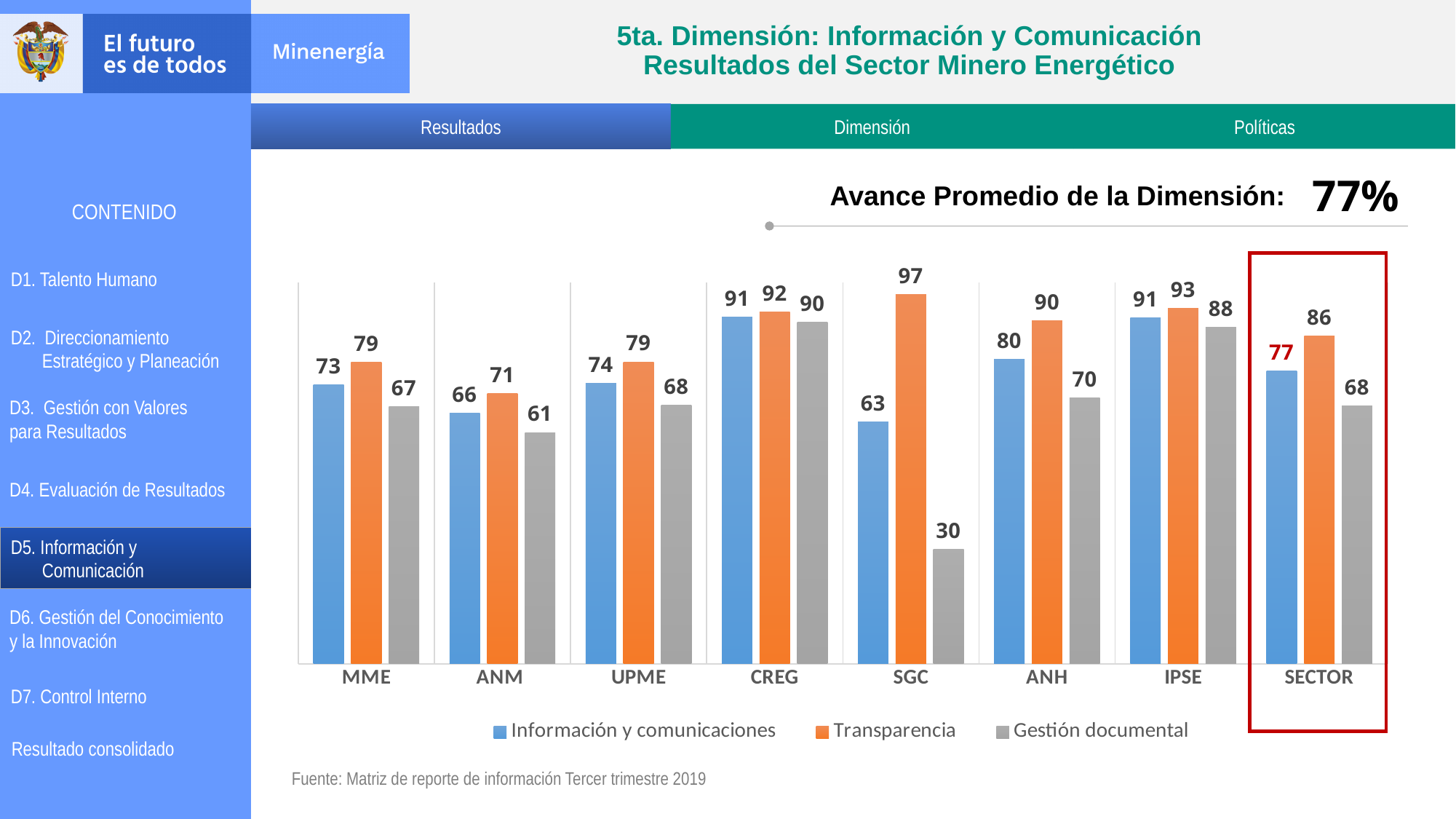
How many categories are shown on the x axis? 8 Which category has the highest Transparencia value? SGC What is the Gestión documental value for ANM? 61 What kind of chart is shown on the slide? Bar chart What is the Avance Promedio de la Dimensión shown above the chart? 77% What is the difference between the Transparencia and Gestión documental values for SGC? 67 What is the Transparencia value for SGC? 97 What is the Información y comunicaciones value for SECTOR? 77 Which series is shown in orange in the legend? Transparencia Which category has the lowest Gestión documental value? SGC Which is larger: the Información y comunicaciones value for CREG or for ANH? CREG How many series does the legend list? 3